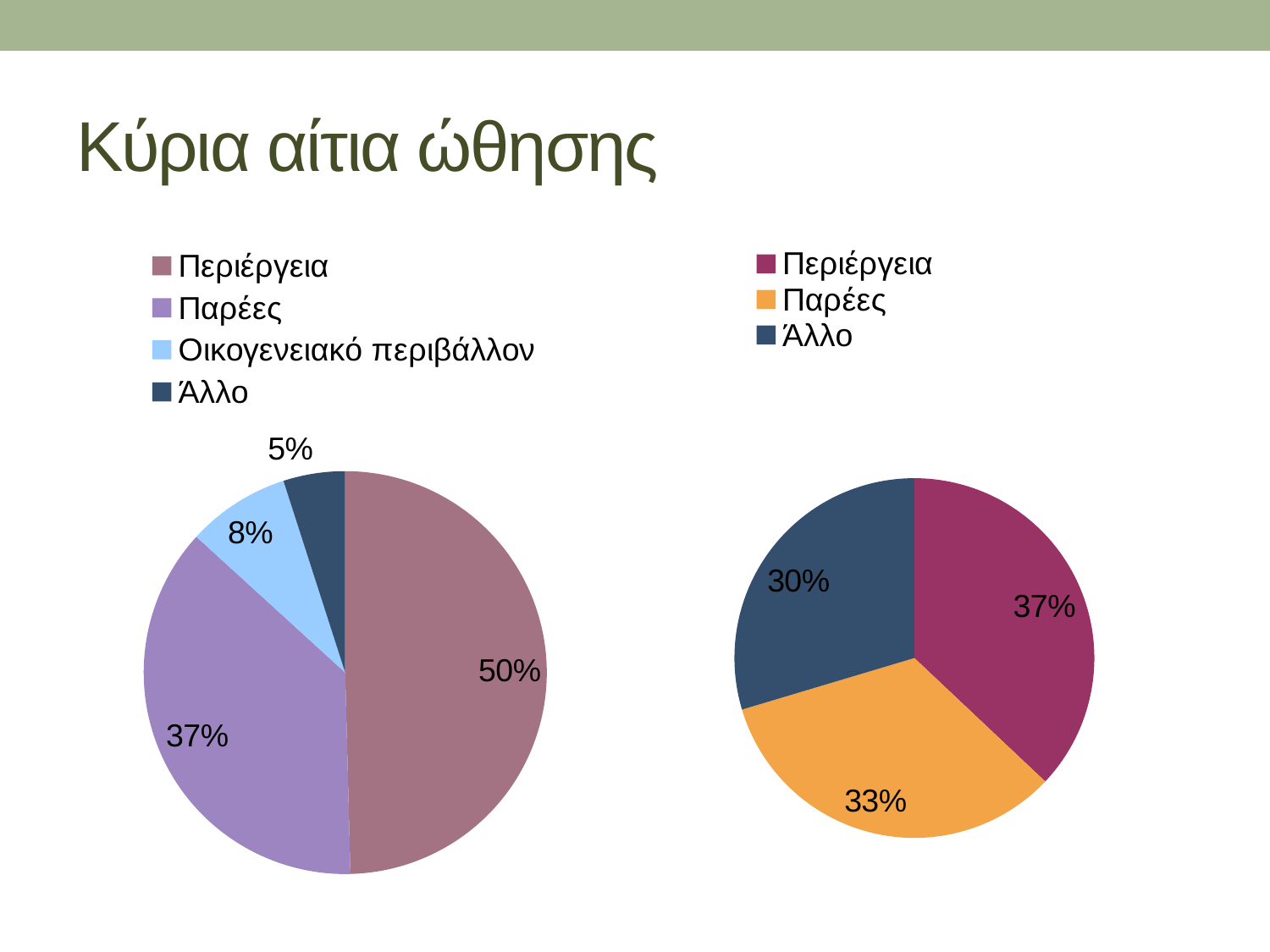
In the right pie chart, which is larger, Παρέες or Άλλο? Παρέες In the right pie chart, what share does Άλλο have? 30% In the left pie chart, what share does Περιέργεια have? 50% In the left pie chart, what share does Άλλο have? 5% How many categories does the legend of the left pie chart list? 4 In the right pie chart, what share does Παρέες have? 33% What type of chart is shown on the right of the slide? Pie chart In the left pie chart, what share does Οικογενειακό περιβάλλον have? 8% In the right pie chart, which category has the largest share? Περιέργεια In the left pie chart, which category has the smallest share? Άλλο In the left pie chart, what is the difference between the shares of Περιέργεια and Παρέες? 13% In the left pie chart, which category has the largest share? Περιέργεια